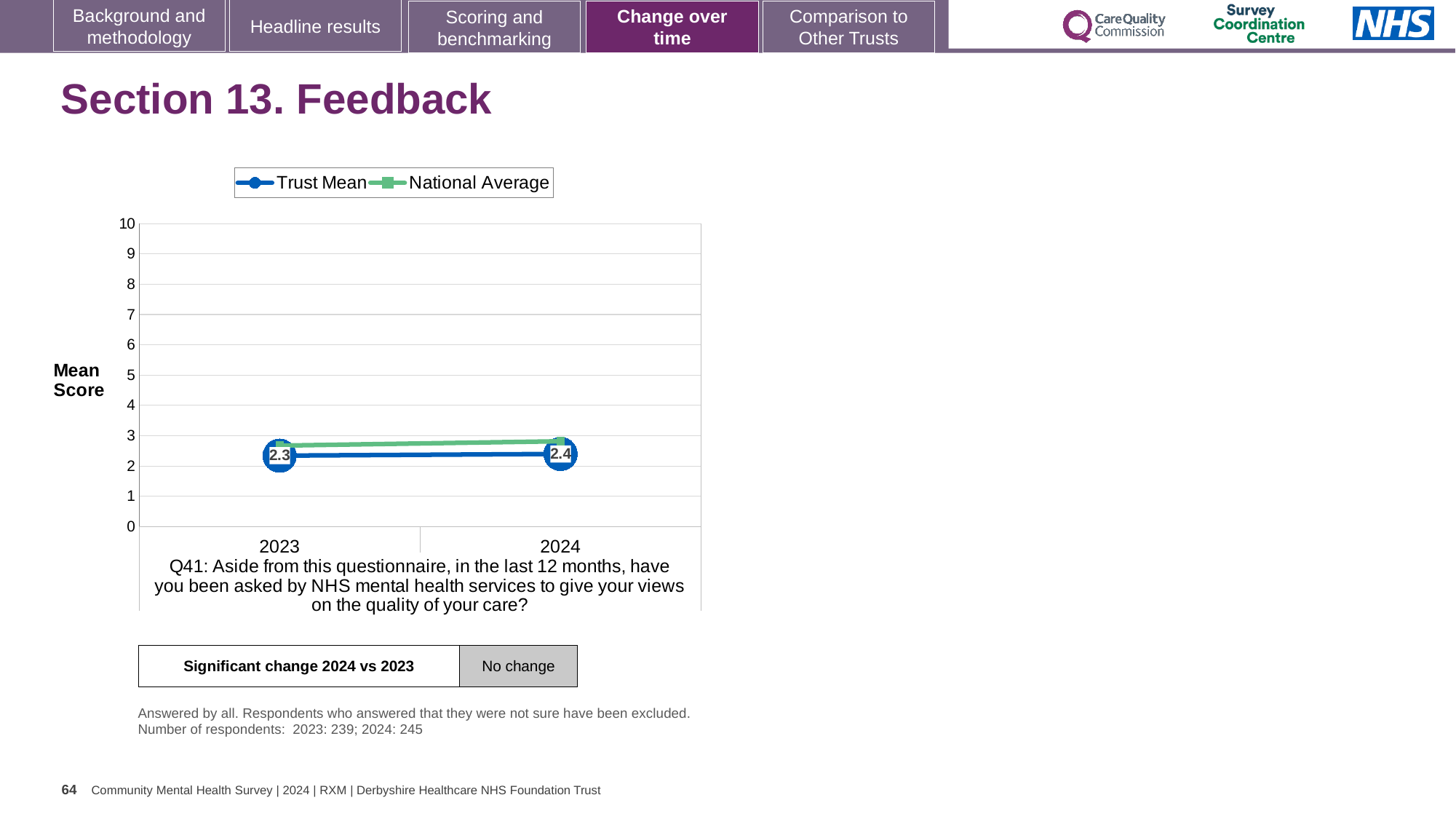
In which year is the Trust Mean lowest? 2023 Is the National Average value for 2024 greater or less than 2? greater How many years are plotted on the x axis? 2 What is the Trust Mean value for 2024? 2.4 In which year is the Trust Mean higher, 2023 or 2024? 2024 What kind of chart is shown on the slide? Line chart Does the Trust Mean rise or fall from 2023 to 2024? Rise What is the Trust Mean value for 2023? 2.3 Is the National Average value for 2023 greater or less than 3? less In 2024, which is larger, the Trust Mean or the National Average? National Average What is the difference between the Trust Mean in 2024 and in 2023? 0.1 How many series does the legend list? 2